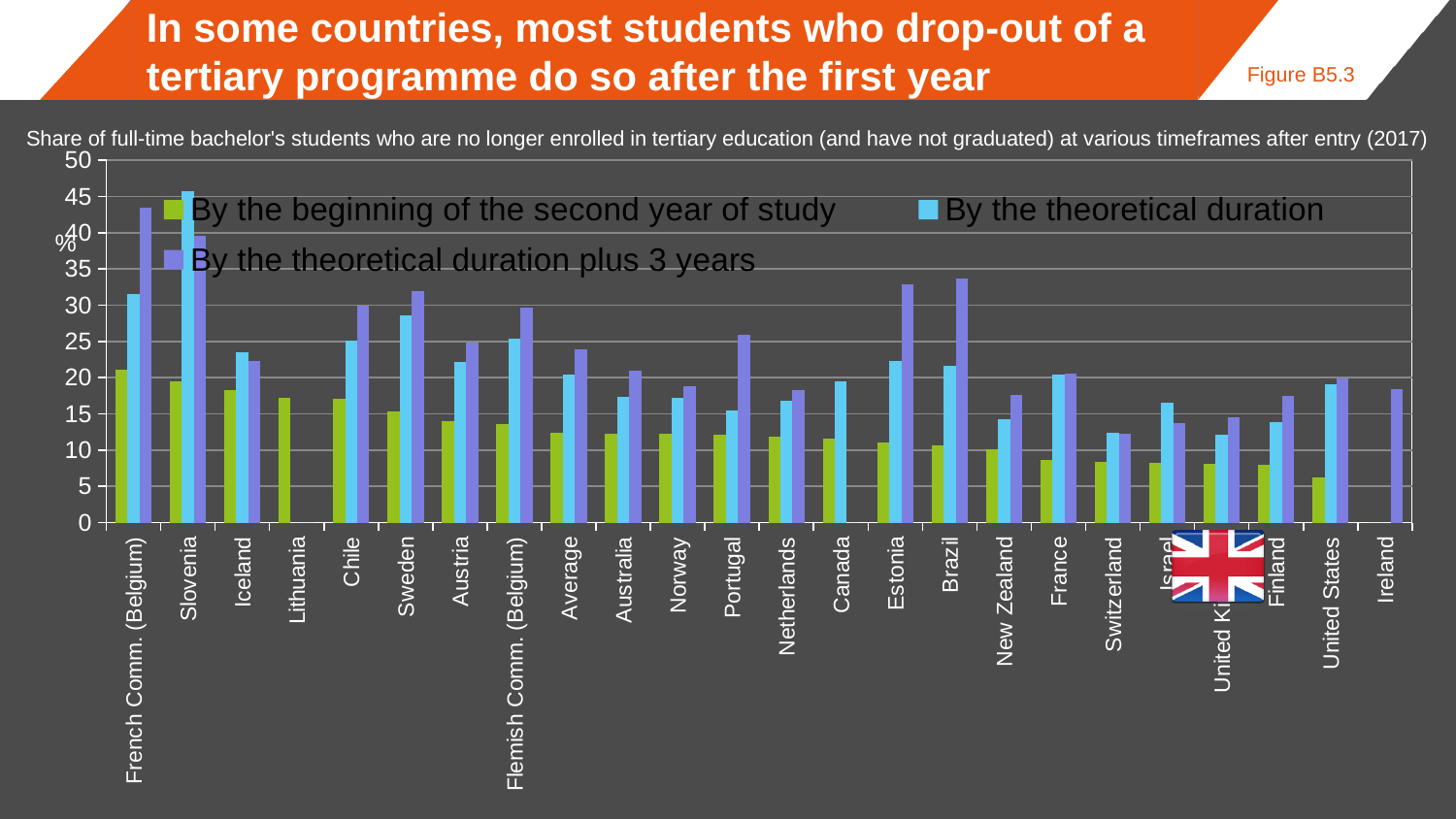
Is the 'By the theoretical duration' value for Slovenia greater or less than 40? greater Is the 'By the theoretical duration plus 3 years' value for Brazil greater or less than 30? greater What kind of chart is shown on the slide? bar chart How many series does the legend list? 3 Do the values for the 'By the beginning of the second year of study' series generally rise or fall from left to right along the x axis? fall What is the figure number shown on the slide? Figure B5.3 How many countries/categories are plotted along the x axis? 24 Which is larger for the 'By the theoretical duration' series: Sweden or Austria? Sweden Which category has the lowest value for the 'By the beginning of the second year of study' series? United States Is the 'By the beginning of the second year of study' value for United States greater or less than 10? less Which category has the highest value for the 'By the theoretical duration' series? Slovenia